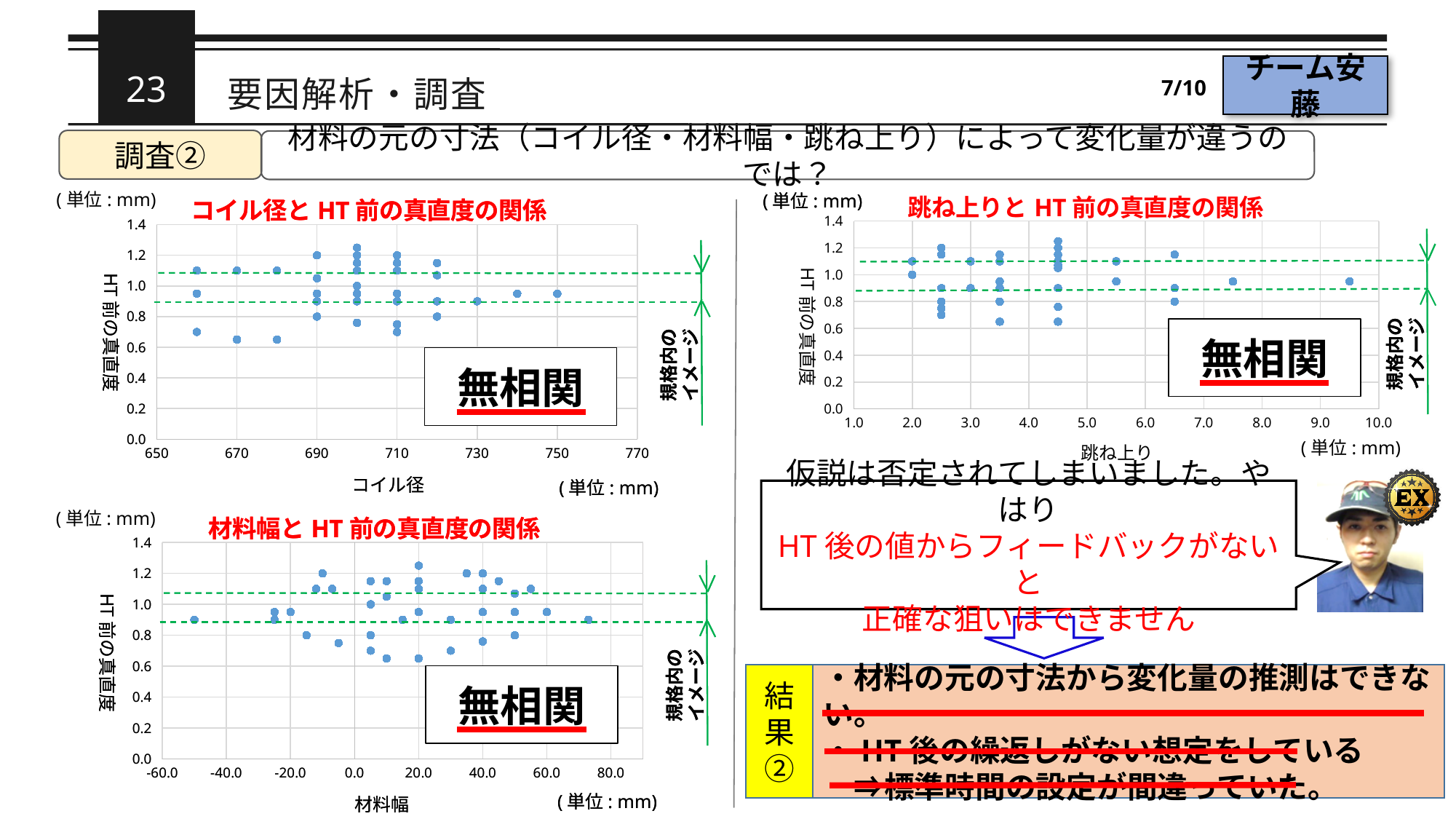
In the chart titled 材料幅とHT前の真直度の関係, is the highest point at 材料幅 -10.0 greater or less than 1.0? greater In the chart titled 材料幅とHT前の真直度の関係, is the lowest point at 材料幅 20.0 greater or less than 0.8? less How many charts are shown on the slide? 3 In the chart titled 跳ね上りとHT前の真直度の関係, is the point at 跳ね上り 6.5 with the highest value greater or less than 1.0? greater What kind of chart is the chart titled 跳ね上りとHT前の真直度の関係? scatter chart What is the x-axis label of the chart titled 跳ね上りとHT前の真直度の関係? 跳ね上り What is the maximum value shown on the y axis of the chart titled 材料幅とHT前の真直度の関係? 1.4 What kind of chart is the chart titled コイル径とHT前の真直度の関係? scatter chart